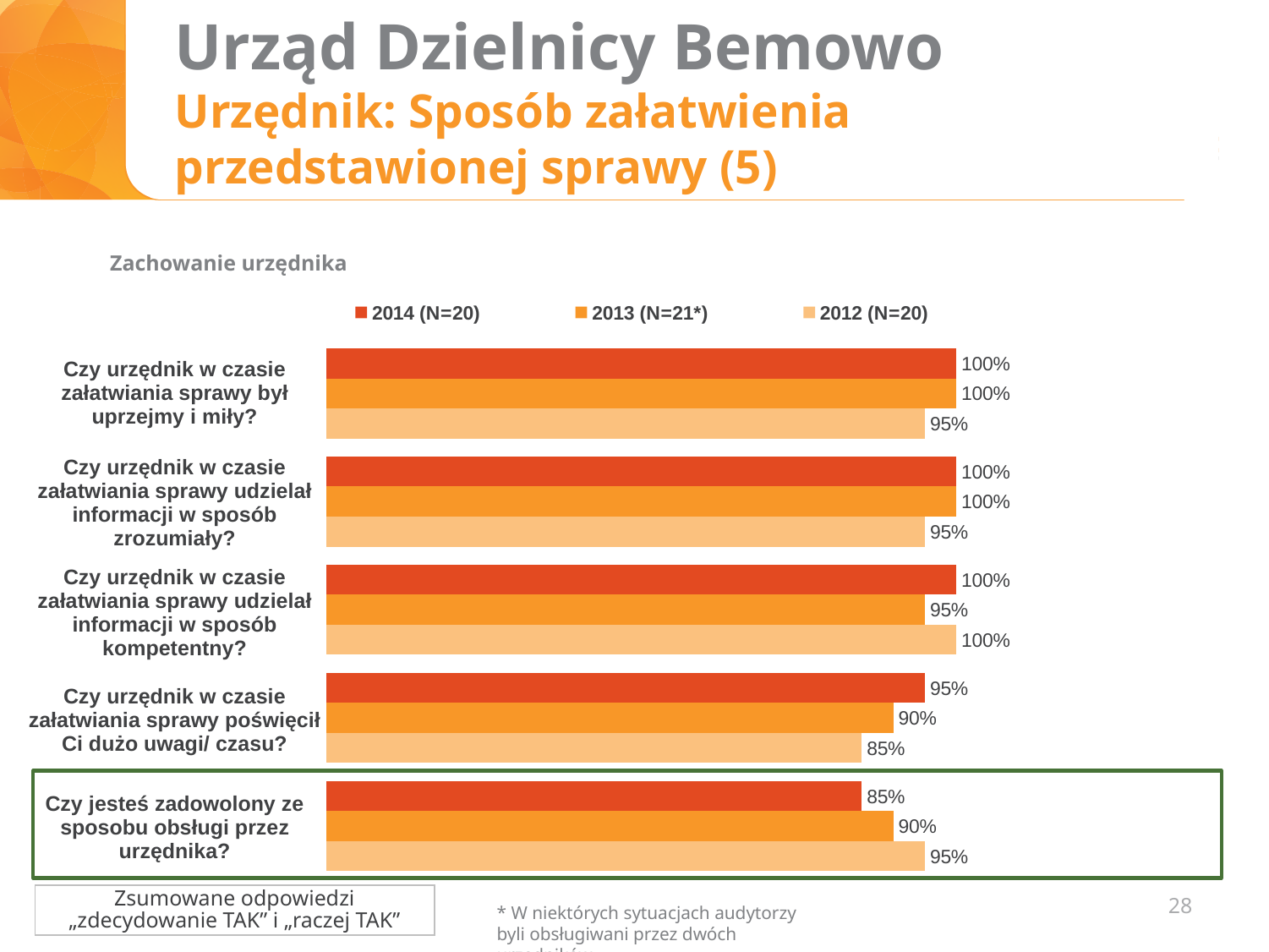
What is the subtitle shown above the chart? Zachowanie urzędnika What kind of chart is shown on the slide? bar chart How many series does the legend list? 3 How many question categories are plotted on the chart? 5 What is the 2012 (N=20) value for "Czy urzędnik w czasie załatwiania sprawy poświęcił Ci dużo uwagi/ czasu?"? 85% What is the 2014 (N=20) value for "Czy jesteś zadowolony ze sposobu obsługi przez urzędnika?"? 85% Which year has the highest value for "Czy urzędnik w czasie załatwiania sprawy poświęcił Ci dużo uwagi/ czasu?"? 2014 (N=20) What is the difference between the 2014 and 2012 values for "Czy urzędnik w czasie załatwiania sprawy poświęcił Ci dużo uwagi/ czasu?"? 10% For "Czy jesteś zadowolony ze sposobu obsługi przez urzędnika?", which is larger: the 2013 value or the 2012 value? 2012 (N=20) What is the 2012 (N=20) value for "Czy urzędnik w czasie załatwiania sprawy był uprzejmy i miły?"? 95% What is the 2013 (N=21*) value for "Czy urzędnik w czasie załatwiania sprawy udzielał informacji w sposób kompetentny?"? 95% Which year has the lowest value for "Czy jesteś zadowolony ze sposobu obsługi przez urzędnika?"? 2014 (N=20)